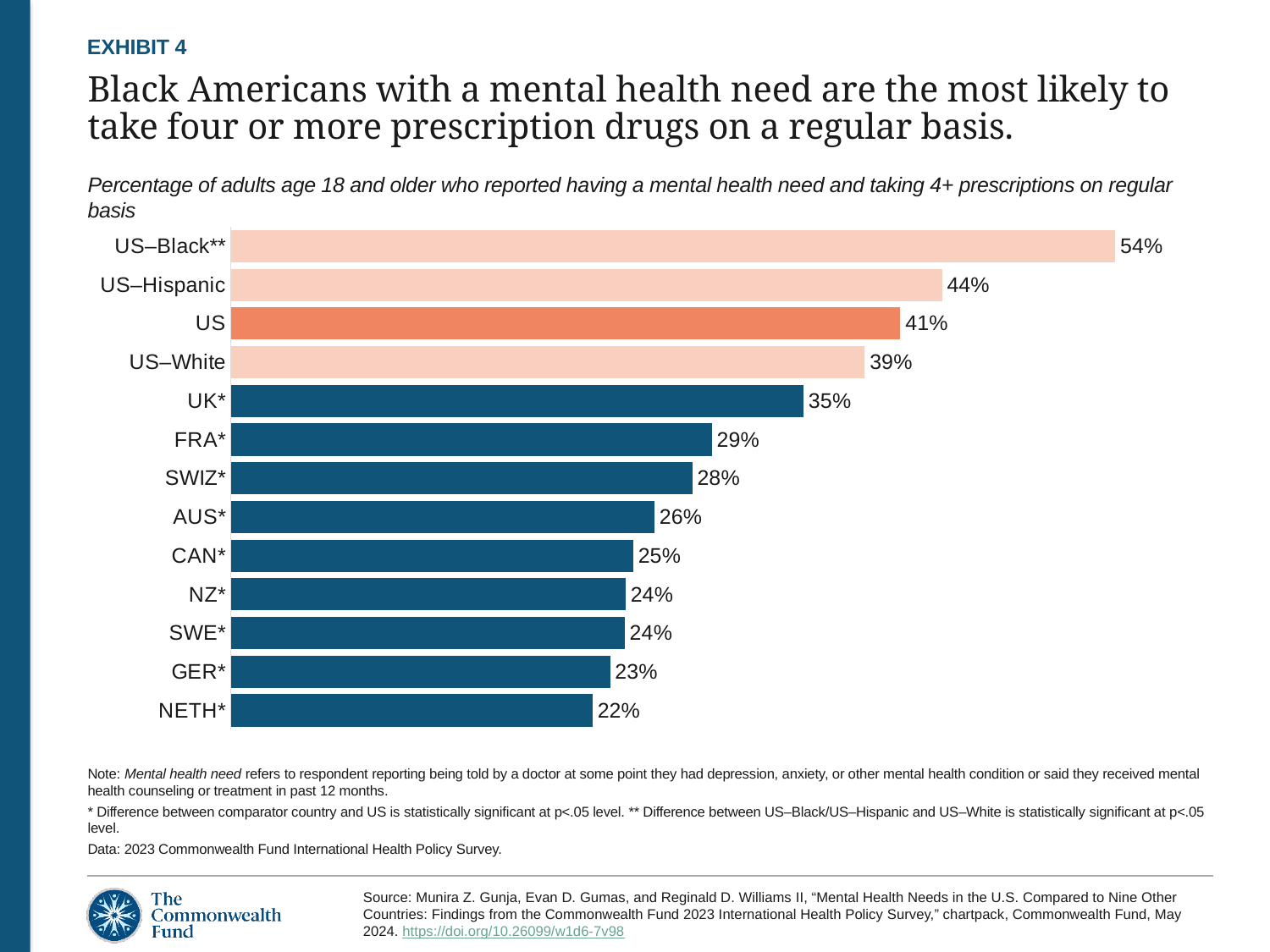
Which bar is shown in a darker orange colour than the other US bars? US Which is larger, the value for FRA* or the value for CAN*? FRA* What is the difference between the values for US–Black** and US–White? 15% Which category has the lowest value? NETH* What is the value for US–Black**? 54% What is the value for UK*? 35% Which two categories share the value 24%? NZ* and SWE* How many categories are shown in the chart? 13 Which category has the highest value? US–Black** What is the difference between the values for US and UK*? 6% What kind of chart is shown on the slide? Bar chart What is the value for NETH*? 22%